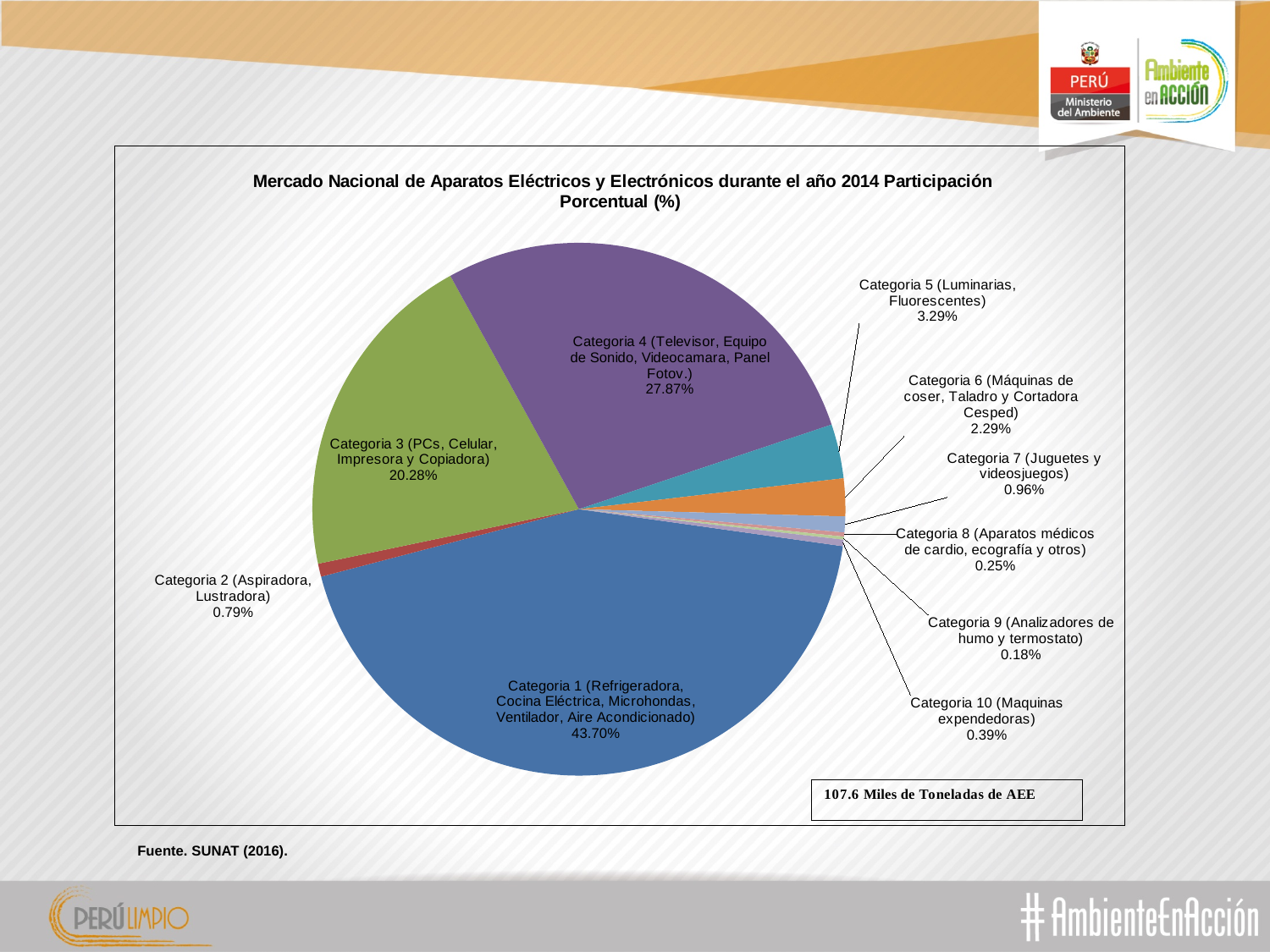
What is the percentage share for Categoria 9 (Analizadores de humo y termostato)? 0.18% What type of chart is shown on the slide? Pie chart Which category has the smallest share of the pie? Categoria 9 (Analizadores de humo y termostato) What is the percentage share for Categoria 5 (Luminarias, Fluorescentes)? 3.29% What is the difference in percentage points between Categoria 4 and Categoria 3? 7.59 What is the percentage share for Categoria 4 (Televisor, Equipo de Sonido, Videocamara, Panel Fotov.)? 27.87% What total quantity is stated in the box at the bottom right of the chart? 107.6 Miles de Toneladas de AEE Which category has the largest share of the pie? Categoria 1 (Refrigeradora, Cocina Eléctrica, Microhondas, Ventilador, Aire Acondicionado) What is the difference in percentage points between Categoria 1 and Categoria 4? 15.83 How many categories are shown in the pie chart? 10 Which has a larger share, Categoria 3 (PCs, Celular, Impresora y Copiadora) or Categoria 4 (Televisor, Equipo de Sonido, Videocamara, Panel Fotov.)? Categoria 4 What is the percentage share for Categoria 1 (Refrigeradora, Cocina Eléctrica, Microhondas, Ventilador, Aire Acondicionado)? 43.70%